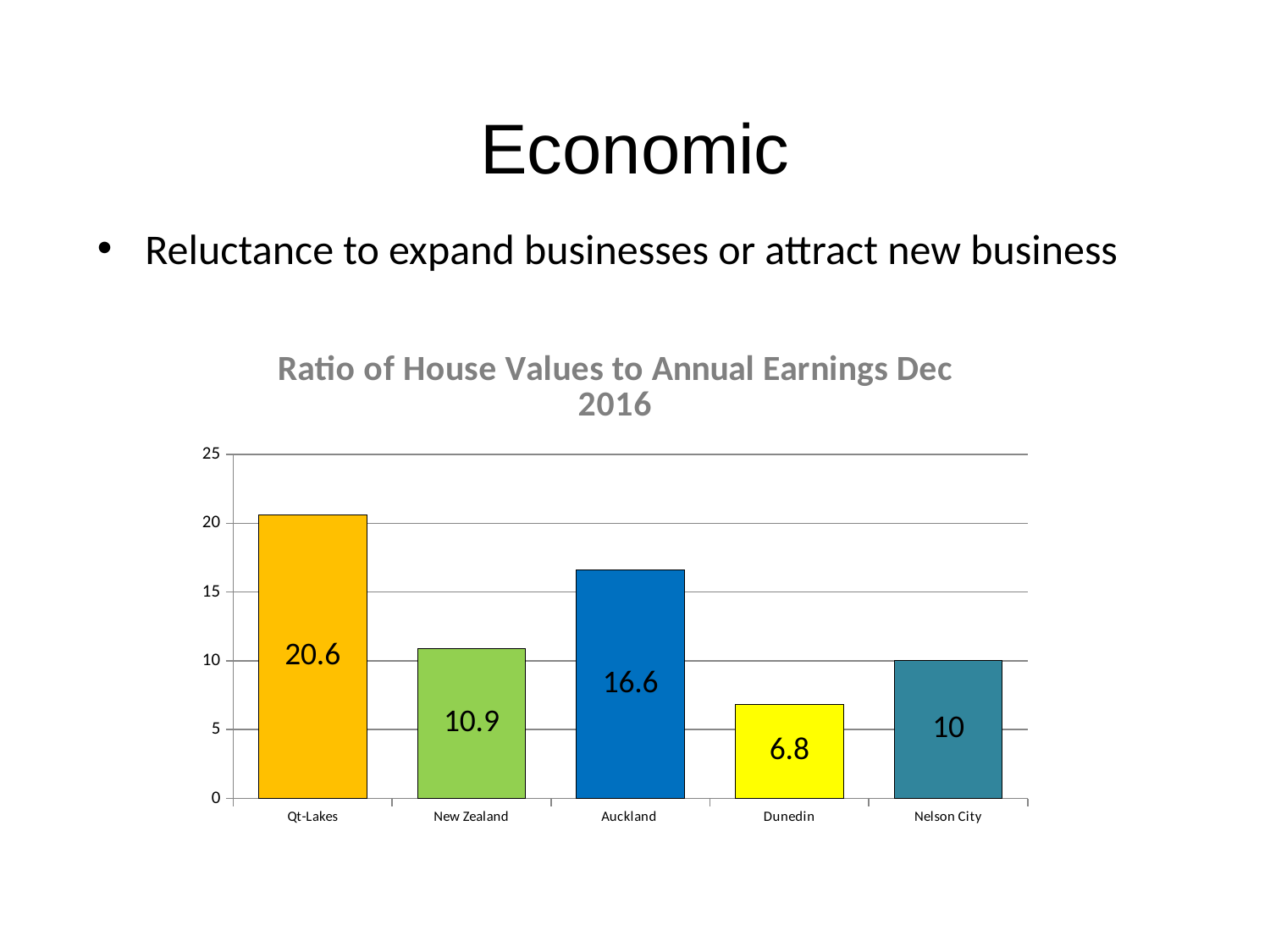
What is the ratio of house values to annual earnings for Dunedin? 6.8 What is the title of the chart? Ratio of House Values to Annual Earnings Dec 2016 What is the ratio of house values to annual earnings for Nelson City? 10 What is the difference between the ratios for New Zealand and Dunedin? 4.1 How many categories are shown in the chart? 5 Which category has the lowest ratio of house values to annual earnings? Dunedin What is the ratio of house values to annual earnings for Qt-Lakes? 20.6 What is the ratio of house values to annual earnings for Auckland? 16.6 What kind of chart is shown on the slide? Bar chart What is the difference between the ratios for Qt-Lakes and Auckland? 4 Which has a higher ratio of house values to annual earnings, New Zealand or Nelson City? New Zealand Which category has the highest ratio of house values to annual earnings? Qt-Lakes